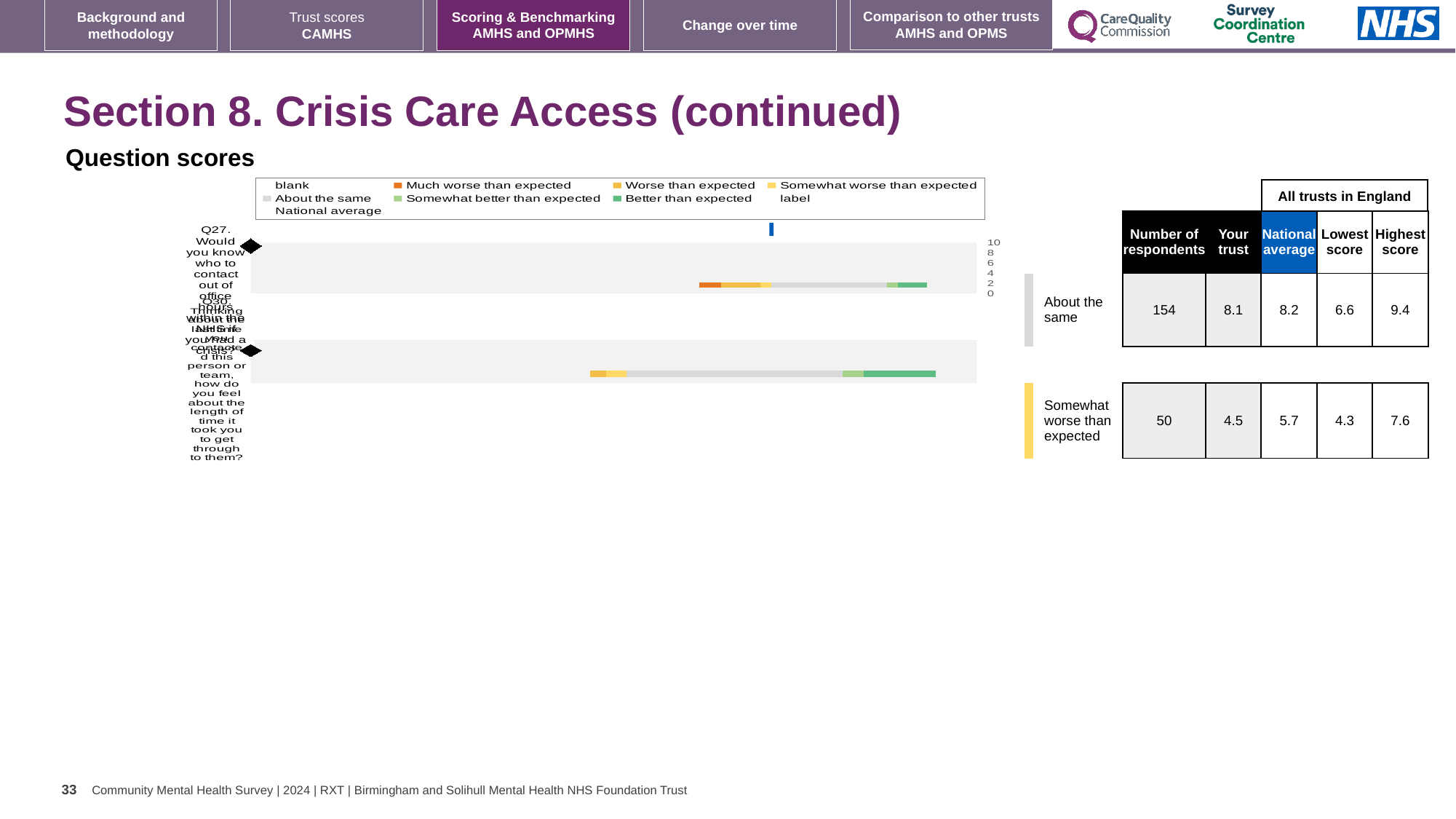
For Q27, which is larger: the 'Your trust' score or the national average? National average Which benchmark category is Q30 placed in? Somewhat worse than expected What is the lowest score among all trusts in England for Q30? 4.3 What is the difference between the highest and lowest scores for Q30? 3.3 What is the difference between the highest and lowest scores for Q27? 2.8 How many questions are plotted in the chart? 2 How many respondents answered Q27? 154 What is the national average for Q30 (how do you feel about the length of time it took you to get through)? 5.7 What is the 'Your trust' score for Q27 (Would you know who to contact out of office hours)? 8.1 Which question has the higher 'Your trust' score, Q27 or Q30? Q27 What colour does the legend use for 'Much worse than expected'? Orange What kind of chart is shown under 'Question scores'? bar chart